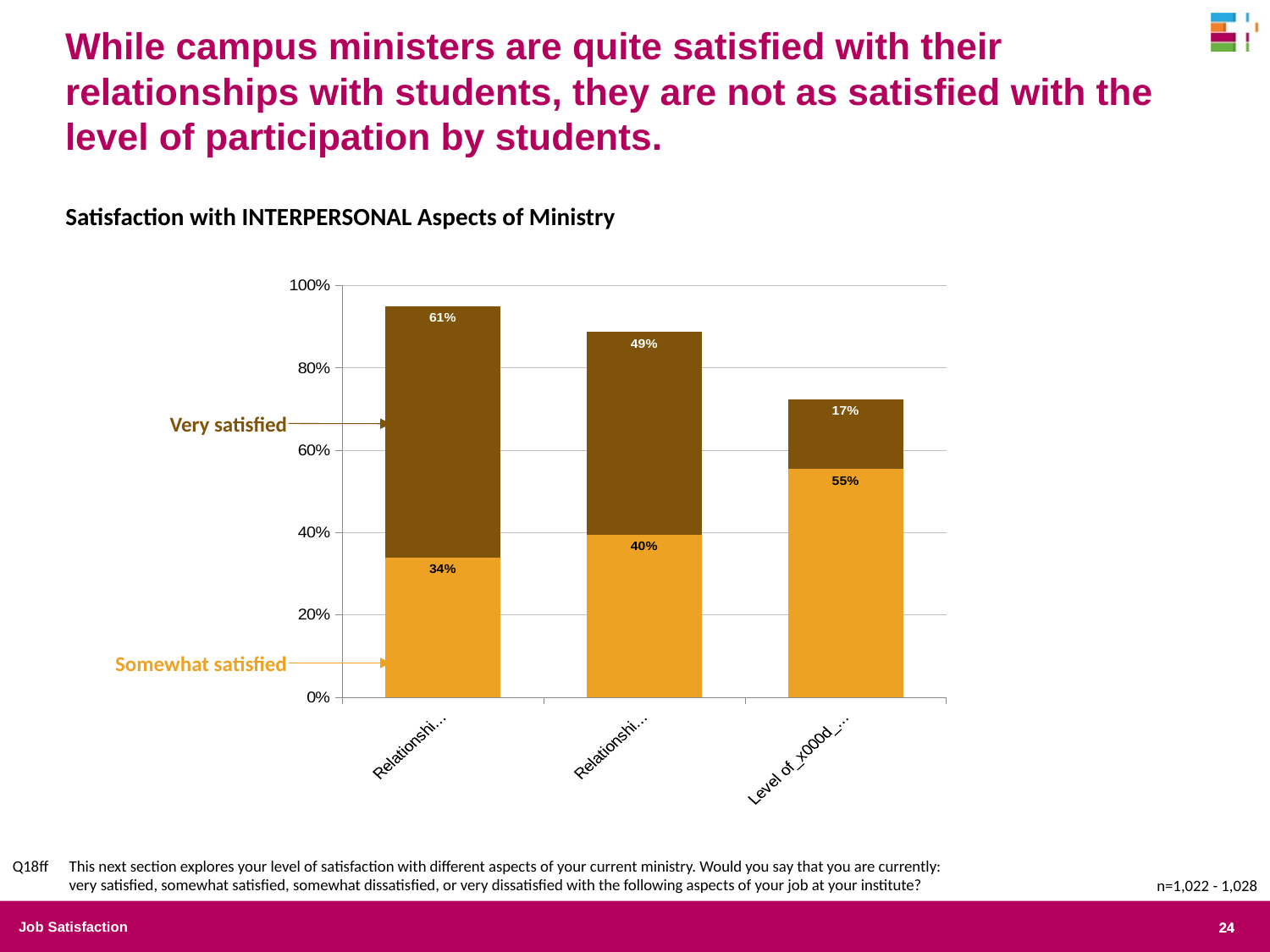
What is the 'Very satisfied' value for the leftmost bar? 61% How many bars are plotted in the chart? 3 What is the difference between the 'Very satisfied' values of the leftmost and rightmost bars? 44% What is the combined total of the rightmost bar? 72% What is the 'Very satisfied' value for the rightmost bar? 17% What is the 'Somewhat satisfied' value for the rightmost bar? 55% What is the 'Somewhat satisfied' value for the middle bar? 40% Is the 'Very satisfied' value larger for the middle bar or the rightmost bar? the middle bar Which bar has the highest 'Very satisfied' value? the leftmost bar Which bar has the lowest 'Somewhat satisfied' value? the leftmost bar What is the combined total of the leftmost bar? 95% What kind of chart is shown on the slide? stacked bar chart